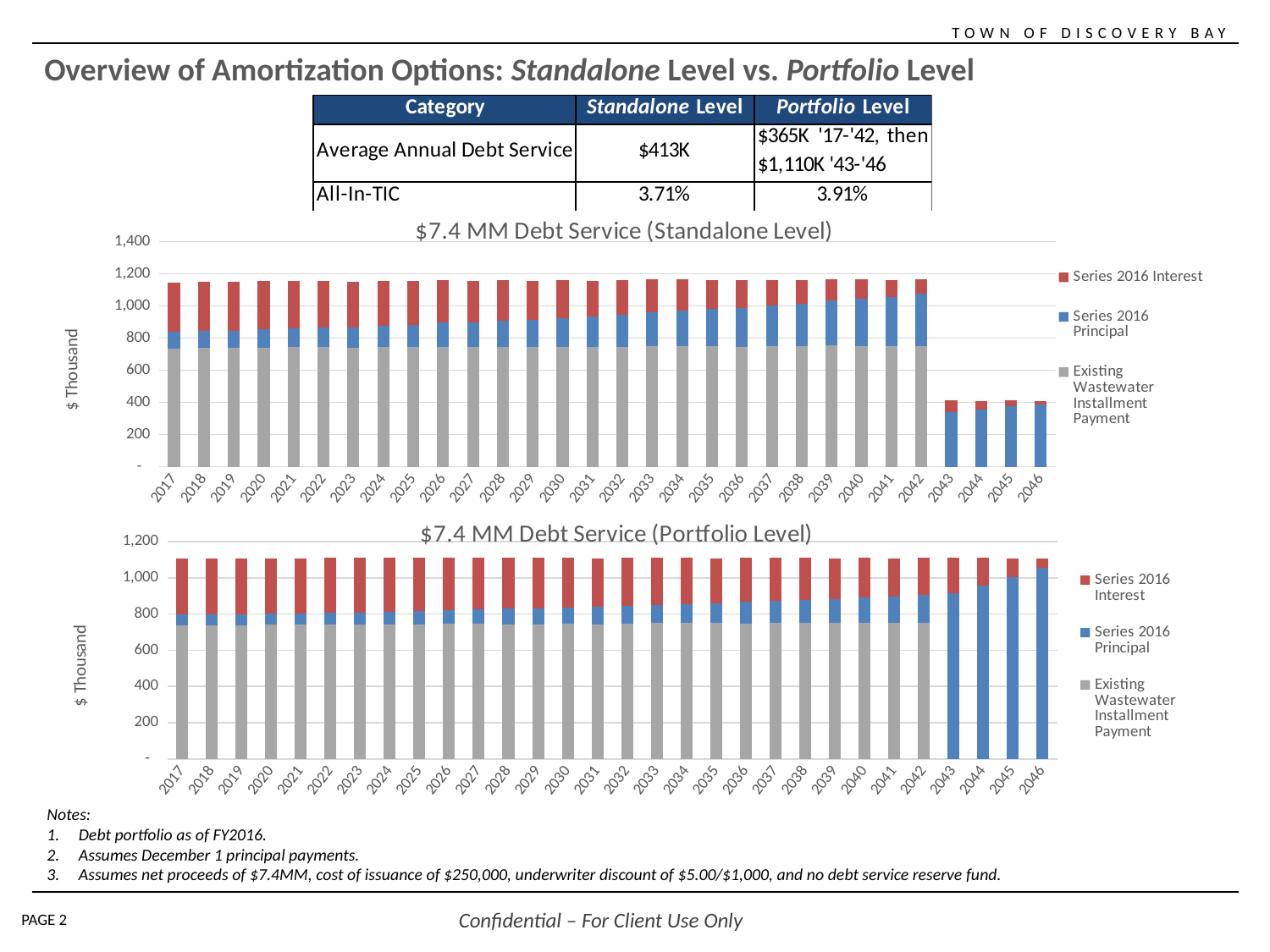
In the "$7.4 MM Debt Service (Portfolio Level)" chart, is the total bar for 2046 greater or less than 1,000? greater How many years are shown on the x axis of the "$7.4 MM Debt Service (Standalone Level)" chart? 30 In the "$7.4 MM Debt Service (Standalone Level)" chart, which year has the larger total bar, 2042 or 2043? 2042 What kind of chart is the "$7.4 MM Debt Service (Standalone Level)" chart? Stacked bar chart In the "$7.4 MM Debt Service (Portfolio Level)" chart, which year has the larger Series 2016 Principal segment, 2017 or 2046? 2046 In the "$7.4 MM Debt Service (Standalone Level)" chart, does the Series 2016 Principal segment rise or fall from 2017 to 2042? Rise In the "$7.4 MM Debt Service (Standalone Level)" chart, is the total bar for 2017 greater or less than 1,000? greater In the "$7.4 MM Debt Service (Portfolio Level)" chart, is the Existing Wastewater Installment Payment for 2017 greater or less than 800? less Which series is shown in red in the "$7.4 MM Debt Service (Standalone Level)" chart? Series 2016 Interest How many series does the legend of the "$7.4 MM Debt Service (Portfolio Level)" chart list? 3 What is the y-axis label of the "$7.4 MM Debt Service (Portfolio Level)" chart? $ Thousand